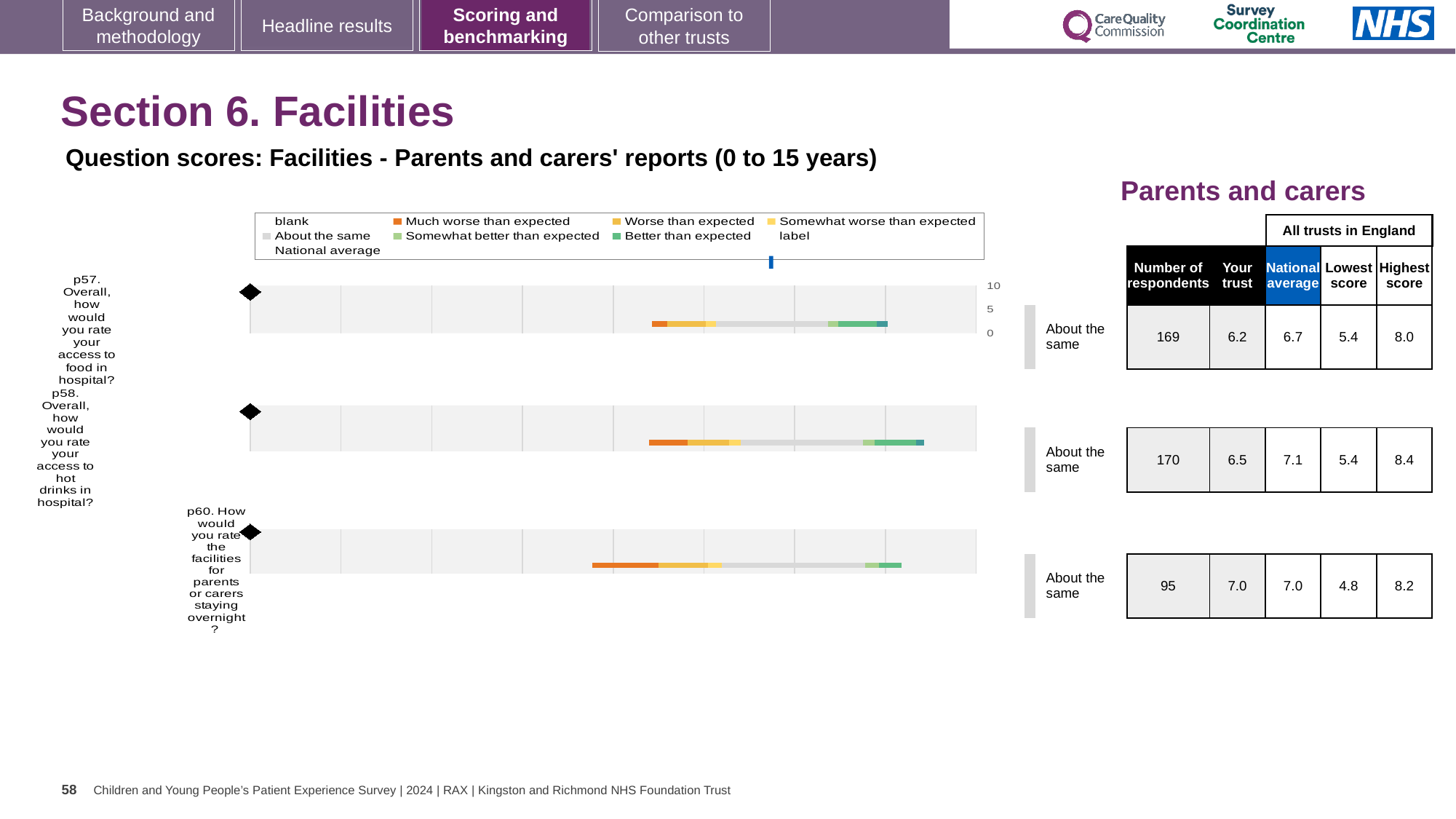
What is the 'Your trust' score for p57 (access to food in hospital)? 6.2 Which benchmark category is shown for p58 (access to hot drinks in hospital)? About the same What is the lowest score among all trusts in England for p60? 4.8 Which question has the highest 'Your trust' score? p60 Which question has the lowest 'Your trust' score? p57 What is the national average score for p58 (access to hot drinks in hospital)? 7.1 What is the difference between the highest score and the lowest score for p58? 3.0 What kind of chart is used to show the question scores for p57, p58 and p60? bar chart How many questions are plotted in the Facilities charts on this slide? 3 For p57, which is larger: the 'Your trust' score or the national average? National average How many respondents answered p60 (facilities for parents or carers staying overnight)? 95 What is the highest value shown on the score axis of the charts? 10